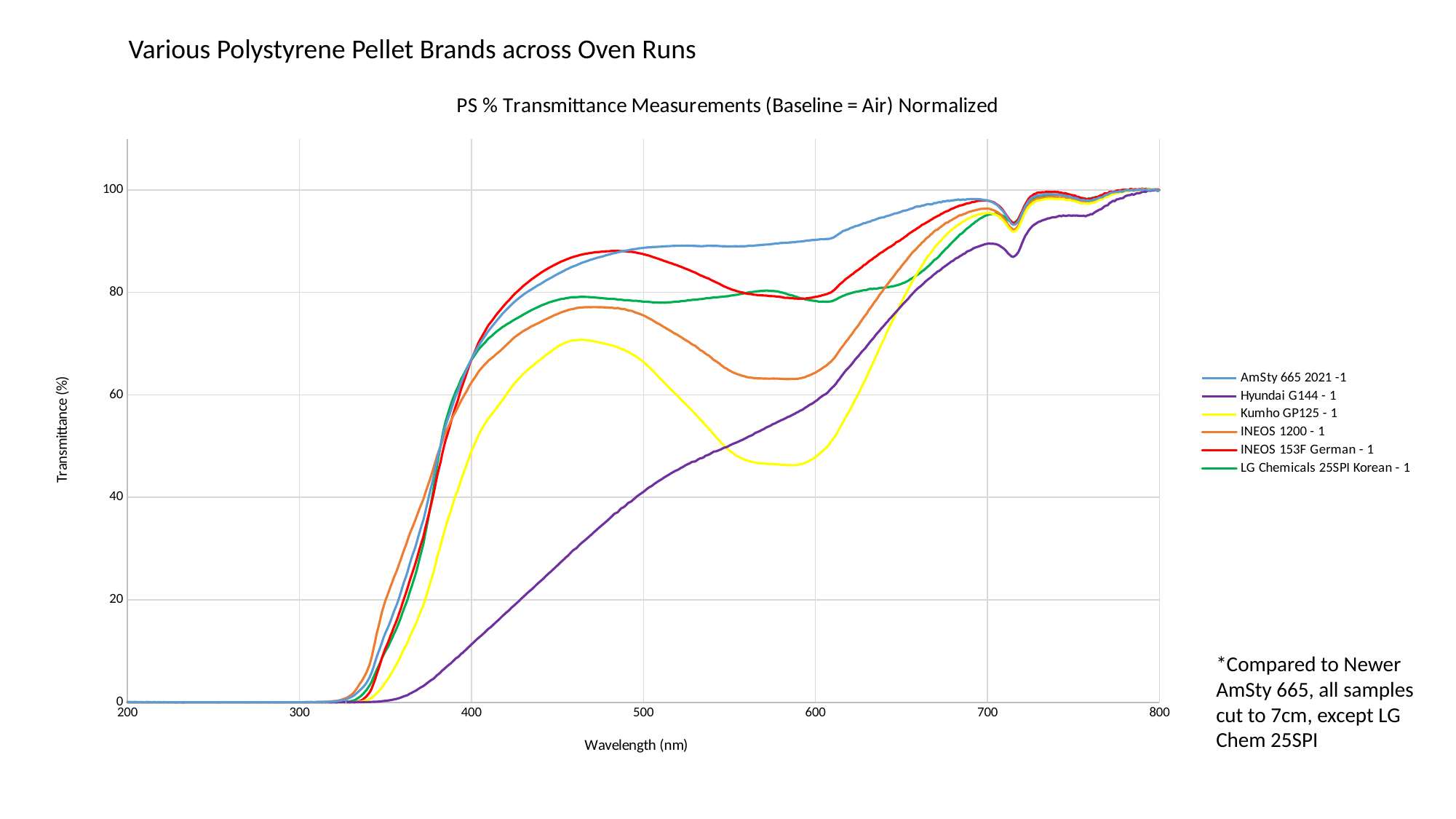
What kind of chart is shown on the slide? line chart What is the title of the chart? PS % Transmittance Measurements (Baseline = Air) Normalized Does the transmittance for Hyundai G144 - 1 rise or fall between 400 nm and 700 nm? rise How many series does the legend list? 6 Is the transmittance for AmSty 665 2021 -1 at 600 nm greater or less than 80? greater Which series has the lowest transmittance at 500 nm? Hyundai G144 - 1 Is the transmittance for Hyundai G144 - 1 at 500 nm greater or less than 60? less At 600 nm, which series has the higher transmittance: INEOS 1200 - 1 or Kumho GP125 - 1? INEOS 1200 - 1 Is the transmittance for Kumho GP125 - 1 at 600 nm greater or less than 60? less At 500 nm, which series has the higher transmittance: AmSty 665 2021 -1 or Hyundai G144 - 1? AmSty 665 2021 -1 What is the label of the x axis? Wavelength (nm)